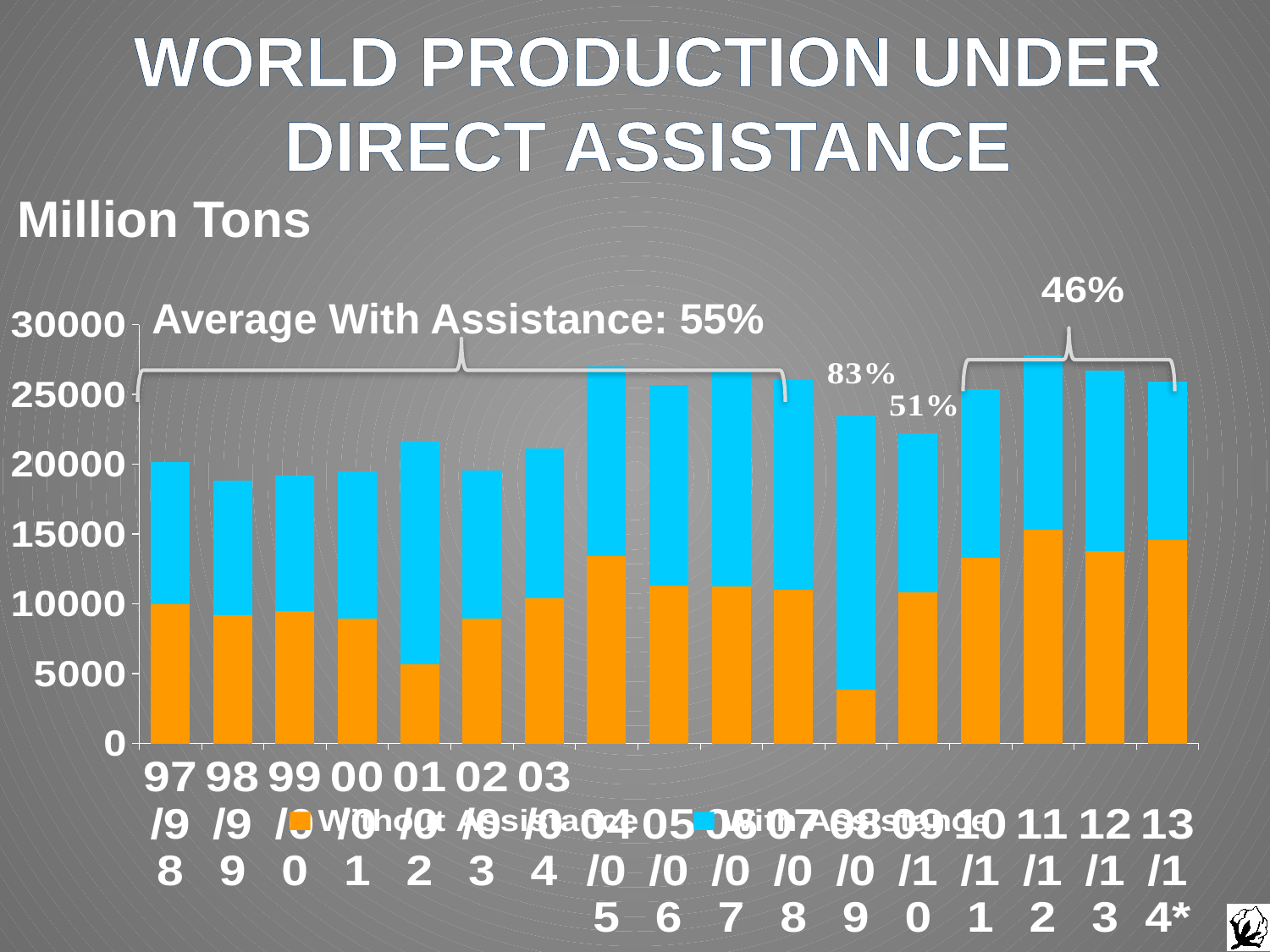
Is the total stacked bar for 97/98 greater or less than 25000? less What kind of chart is shown on the slide? Stacked bar chart Is the total stacked bar for 04/05 greater or less than 25000? greater Which season has the larger total stacked bar, 01/02 or 02/03? 01/02 What are the two series named in the legend? Without Assistance and With Assistance Which season has the tallest stacked bar (highest total production)? 11/12 What is the title of the chart? WORLD PRODUCTION UNDER DIRECT ASSISTANCE How many seasons (categories) are plotted along the x axis? 17 How many series does the legend list? 2 Which season has the smallest Without Assistance (orange) segment? 08/09 Which is larger, the Without Assistance value for 08/09 or for 09/10? 09/10 Is the Without Assistance value for 01/02 greater or less than 10000? less